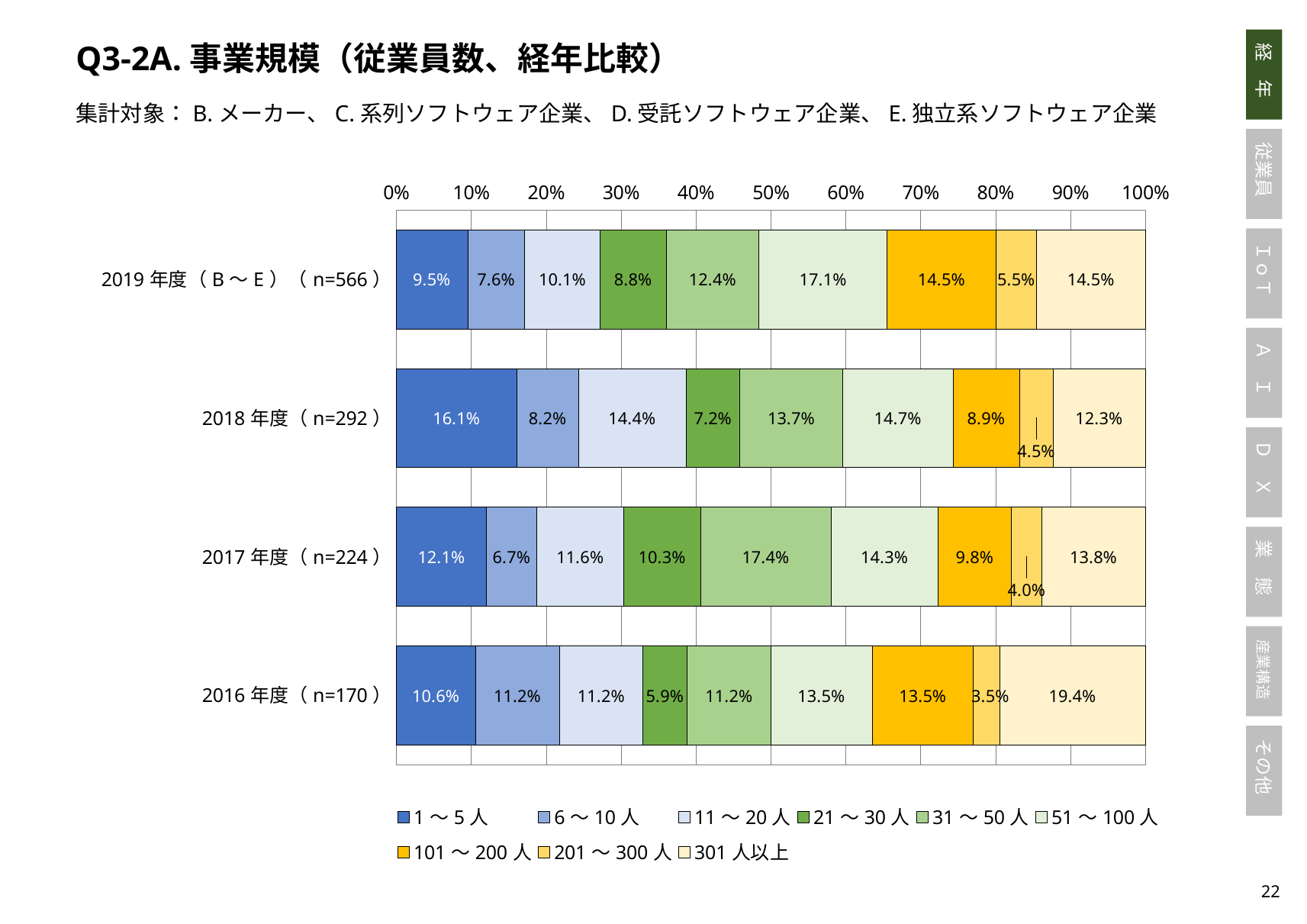
What is the value for 51～100人 in 2019年度 (B～E) (n=566)? 17.1% What is the value for 201～300人 in 2017年度 (n=224)? 4.0% Which year has the highest value for 1～5人? 2018年度 (n=292) Which year has the lowest value for 201～300人? 2016年度 (n=170) How many year categories are plotted on the chart? 4 Which is larger: the 101～200人 value in 2019年度 or in 2018年度? 2019年度 (14.5%) What type of chart is shown on the slide? Stacked bar chart How many series does the legend list? 9 What is the sample size (n) shown for 2017年度? 224 What is the value for 301人以上 in 2016年度 (n=170)? 19.4% What is the difference between the 31～50人 values for 2017年度 and 2019年度? 5.0% What is the value for 1～5人 in 2018年度 (n=292)? 16.1%